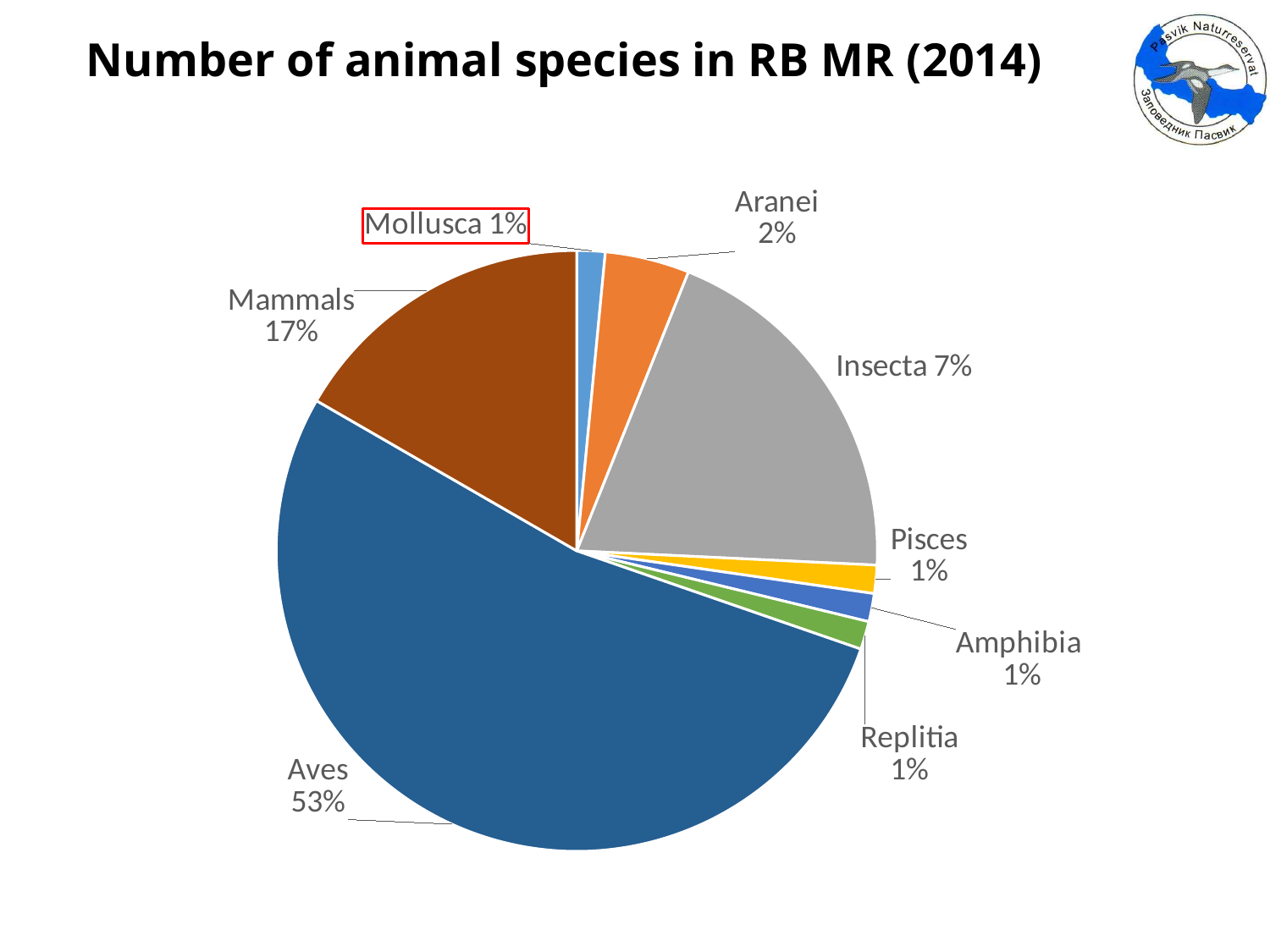
Which data label is outlined with a red box? Mollusca 1% What is the value shown for Mollusca? 1% What share of the pie does Aves account for? 53% What is the title of the chart? Number of animal species in RB MR (2014) What is the value shown for Mammals? 17% What is the value shown for Amphibia? 1% Which is larger, the slice for Aranei or the slice for Pisces? Aranei Which category has the largest slice of the pie? Aves What is the difference in percentage points between Aves and Mammals? 36 percentage points How many categories are shown in the pie chart? 8 What kind of chart is shown on the slide? pie chart What is the value shown for Aranei? 2%